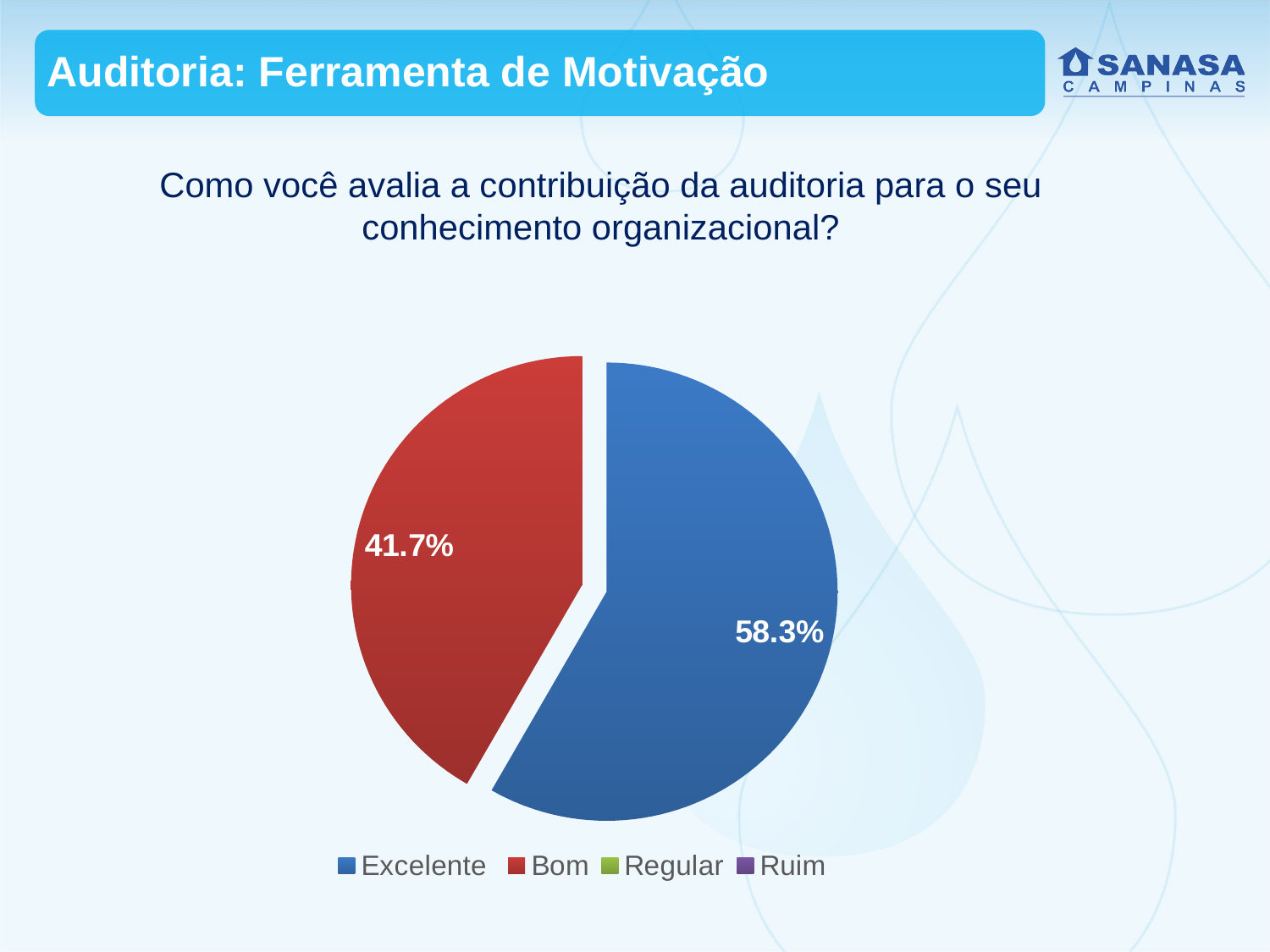
Which legend categories have no visible slice in the pie chart? Regular and Ruim Which colour represents the Bom category in the pie chart? red Which category has the largest slice of the pie? Excelente Which colour represents the Excelente category in the pie chart? blue Is the share for Excelente greater or less than 50%? greater What kind of chart is shown on the slide? pie chart Which of the two visible slices is larger, Excelente or Bom? Excelente How many categories does the legend list? 4 How many slices are visible in the pie chart? 2 What is the difference in percentage points between the Excelente and Bom slices? 16.6 What share of the pie does the Bom slice represent? 41.7% What share of the pie does the Excelente slice represent? 58.3%